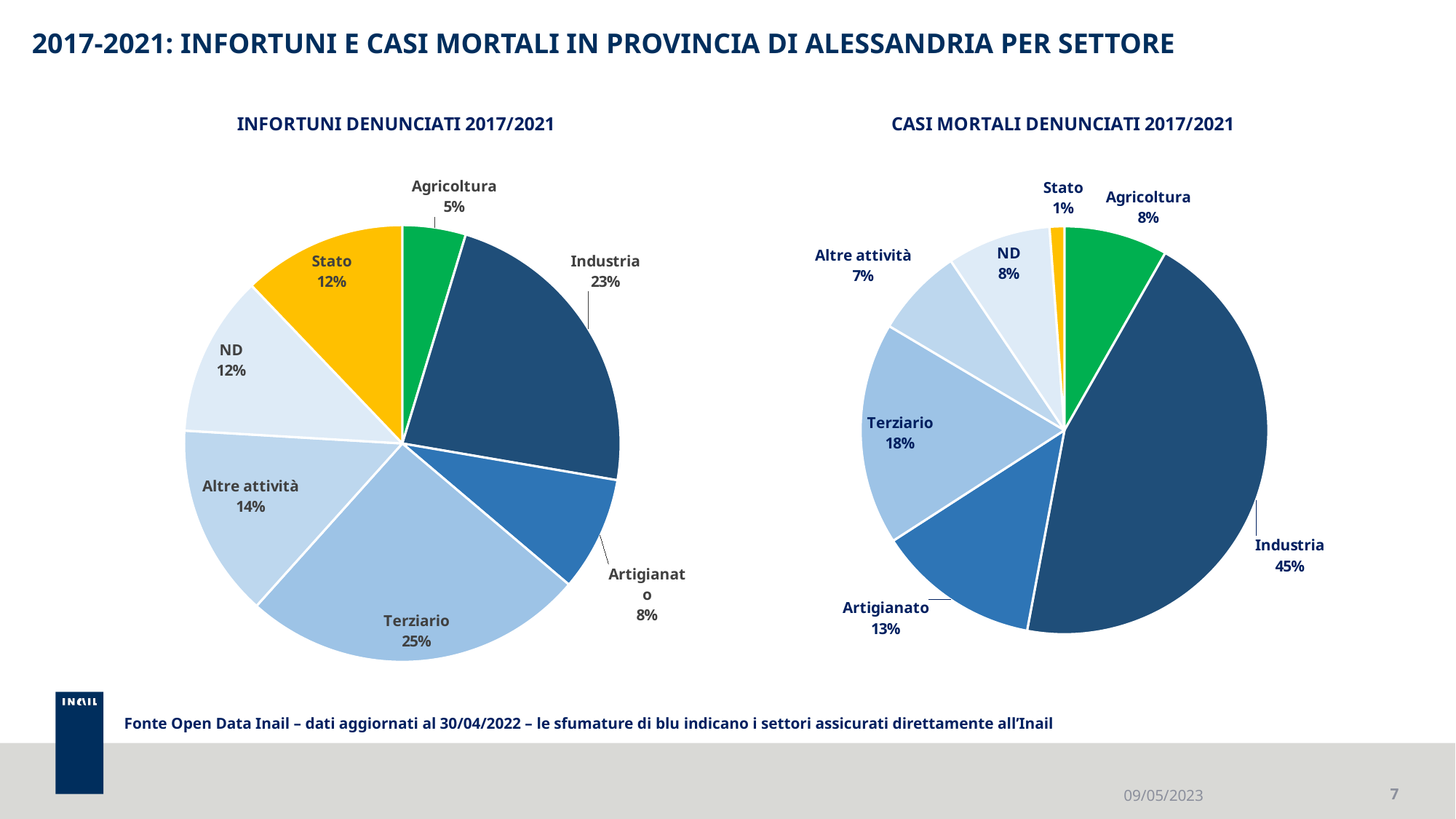
In the 'CASI MORTALI DENUNCIATI 2017/2021' pie chart, what share does Industria have? 45% In the 'CASI MORTALI DENUNCIATI 2017/2021' pie chart, what is the difference between Industria and Terziario? 27% In the 'INFORTUNI DENUNCIATI 2017/2021' pie chart, how many slices are there? 7 In the 'CASI MORTALI DENUNCIATI 2017/2021' pie chart, what is the value for Artigianato? 13% In the 'INFORTUNI DENUNCIATI 2017/2021' pie chart, which sector has the smallest slice? Agricoltura In the 'INFORTUNI DENUNCIATI 2017/2021' pie chart, what is the value for Agricoltura? 5% In the 'INFORTUNI DENUNCIATI 2017/2021' pie chart, what is the difference between Industria and Artigianato? 15% What type of chart is used on the left side of the slide? Pie chart In the 'CASI MORTALI DENUNCIATI 2017/2021' pie chart, which sector has the smallest slice? Stato In the 'INFORTUNI DENUNCIATI 2017/2021' pie chart, what share does Terziario have? 25% In the 'INFORTUNI DENUNCIATI 2017/2021' pie chart, which sector has the largest slice? Terziario In the 'CASI MORTALI DENUNCIATI 2017/2021' pie chart, which is larger, Terziario or Agricoltura? Terziario